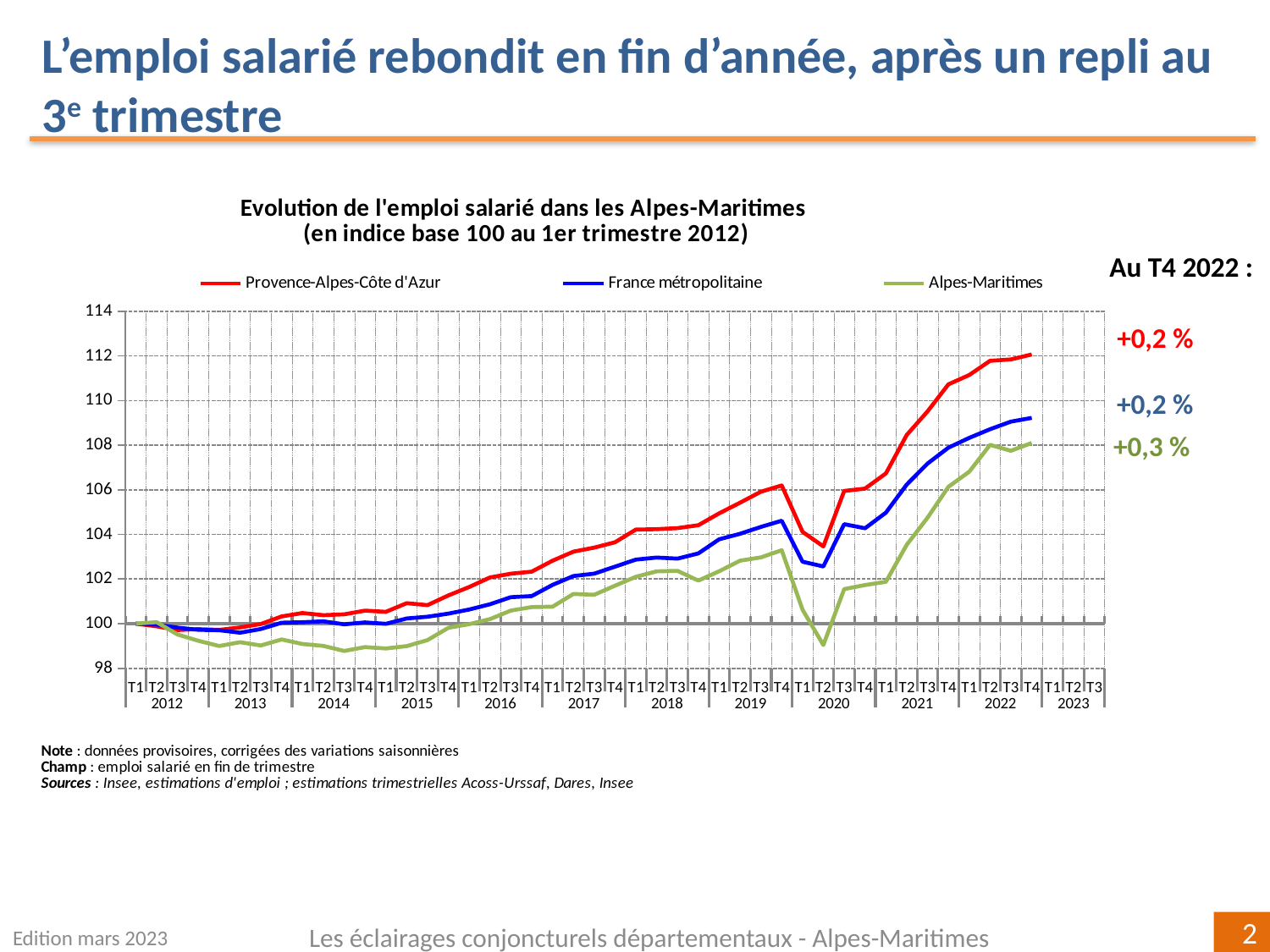
Is the value for France métropolitaine at T4 2022 greater or less than 108? greater How many series does the legend list? 3 Is the value for Provence-Alpes-Côte d'Azur at T4 2022 greater or less than 110? greater What change is shown for Provence-Alpes-Côte d'Azur at T4 2022? +0,2 % At T4 2022, which series has the higher value: Provence-Alpes-Côte d'Azur or Alpes-Maritimes? Provence-Alpes-Côte d'Azur Is the value for Alpes-Maritimes at T2 2020 greater or less than 100? less What is the title of the chart? Evolution de l'emploi salarié dans les Alpes-Maritimes (en indice base 100 au 1er trimestre 2012) What type of chart is shown on the slide? line chart Which series has the lowest value at T4 2022? Alpes-Maritimes What change is shown for Alpes-Maritimes at T4 2022? +0,3 % What is the index value of all series at T1 2012? 100 Overall, do the values rise or fall from 2012 to 2022? rise